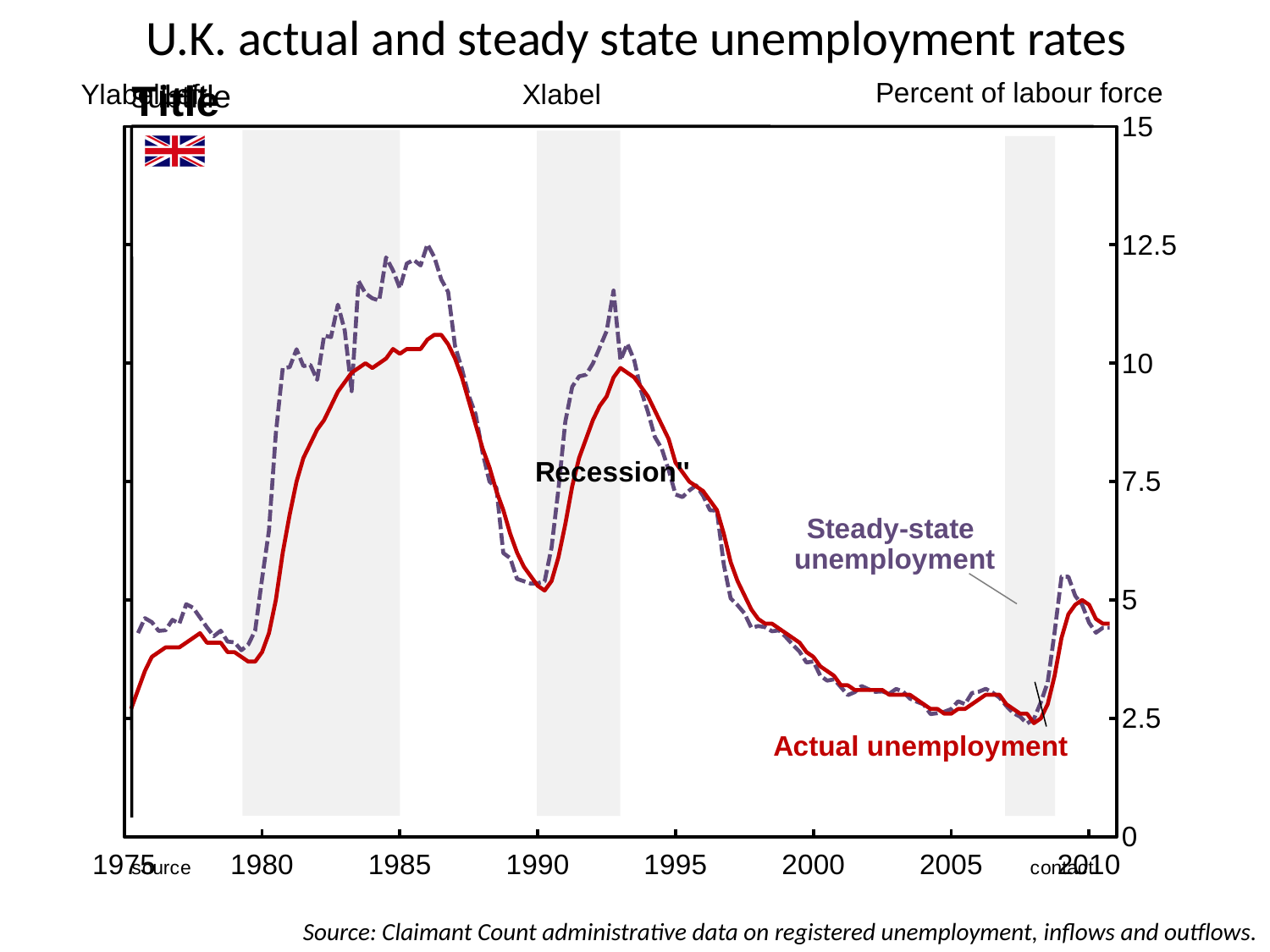
Is the highest value reached by actual unemployment greater or less than 10? greater Is the value of actual unemployment in 1985 greater or less than 7.5? greater Does actual unemployment rise or fall between 1993 and 2005? fall Is the value of actual unemployment in 2000 greater or less than 5? less What kind of chart is shown on the slide? line chart What is the title of the chart? U.K. actual and steady state unemployment rates What unit is given for the vertical axis? Percent of labour force Does actual unemployment rise or fall between 1980 and 1986? rise In 1985, which series has the higher value, actual unemployment or steady-state unemployment? Steady-state unemployment How many series are plotted on the chart? 2